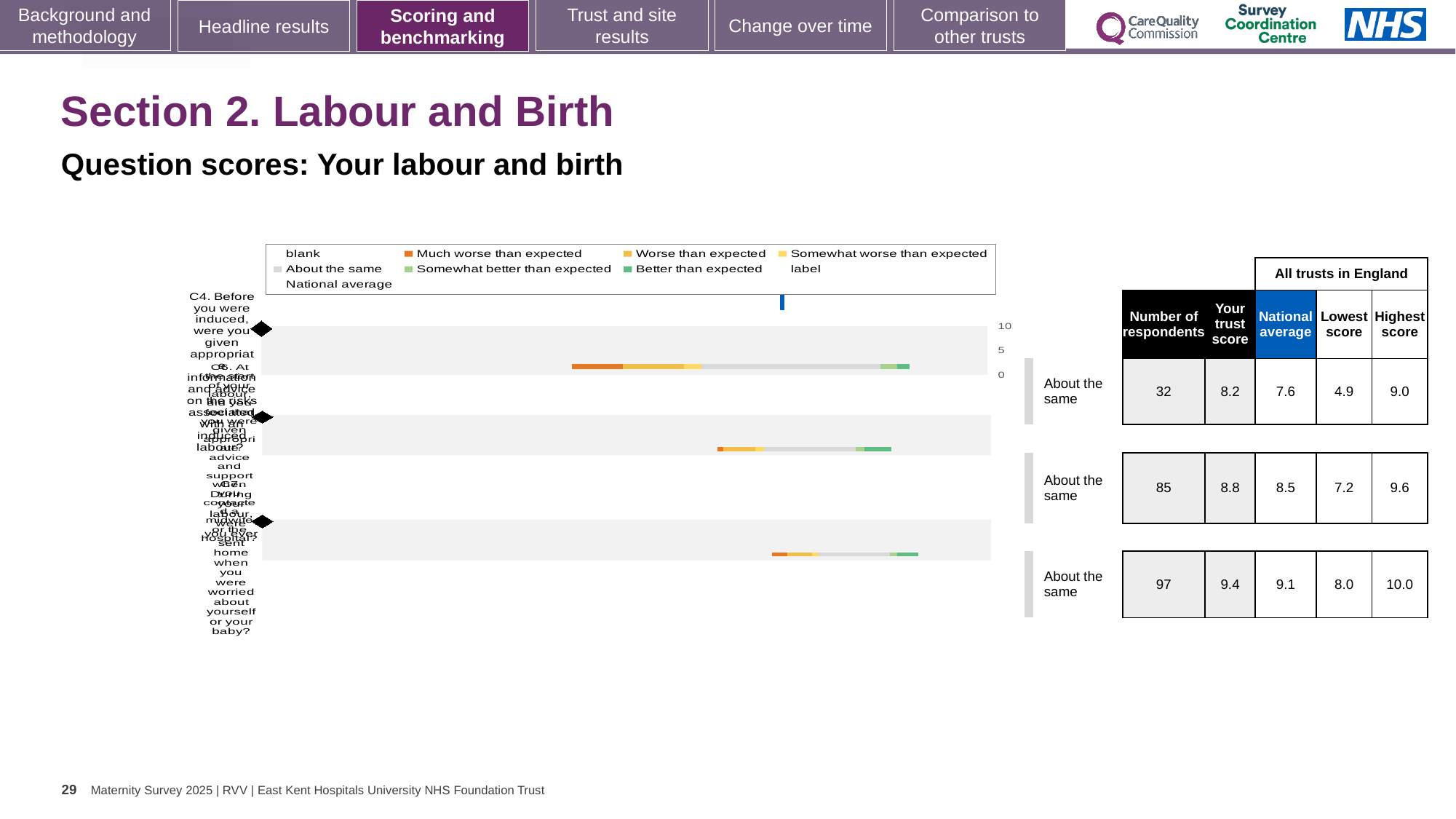
In the table, what is the national average for the second row? 8.5 In the table, which row has the most respondents? the third row (97) Which legend entry is shown in orange in the chart? Much worse than expected What kind of chart is shown on the slide? bar chart In the table, for the first row, which is larger: the trust score or the national average? the trust score (8.2) In the table, what is the lowest score for the second row? 7.2 In the table, what is the difference between the highest score and the lowest score for the first row? 4.1 How many question bars are plotted in the chart? 3 In the table, what is the highest score for the third row? 10.0 In the table, what is the trust score for the first row (C4)? 8.2 What benchmark label is shown next to each of the three bars in the chart? About the same In the table, what is the number of respondents for the first row (C4)? 32